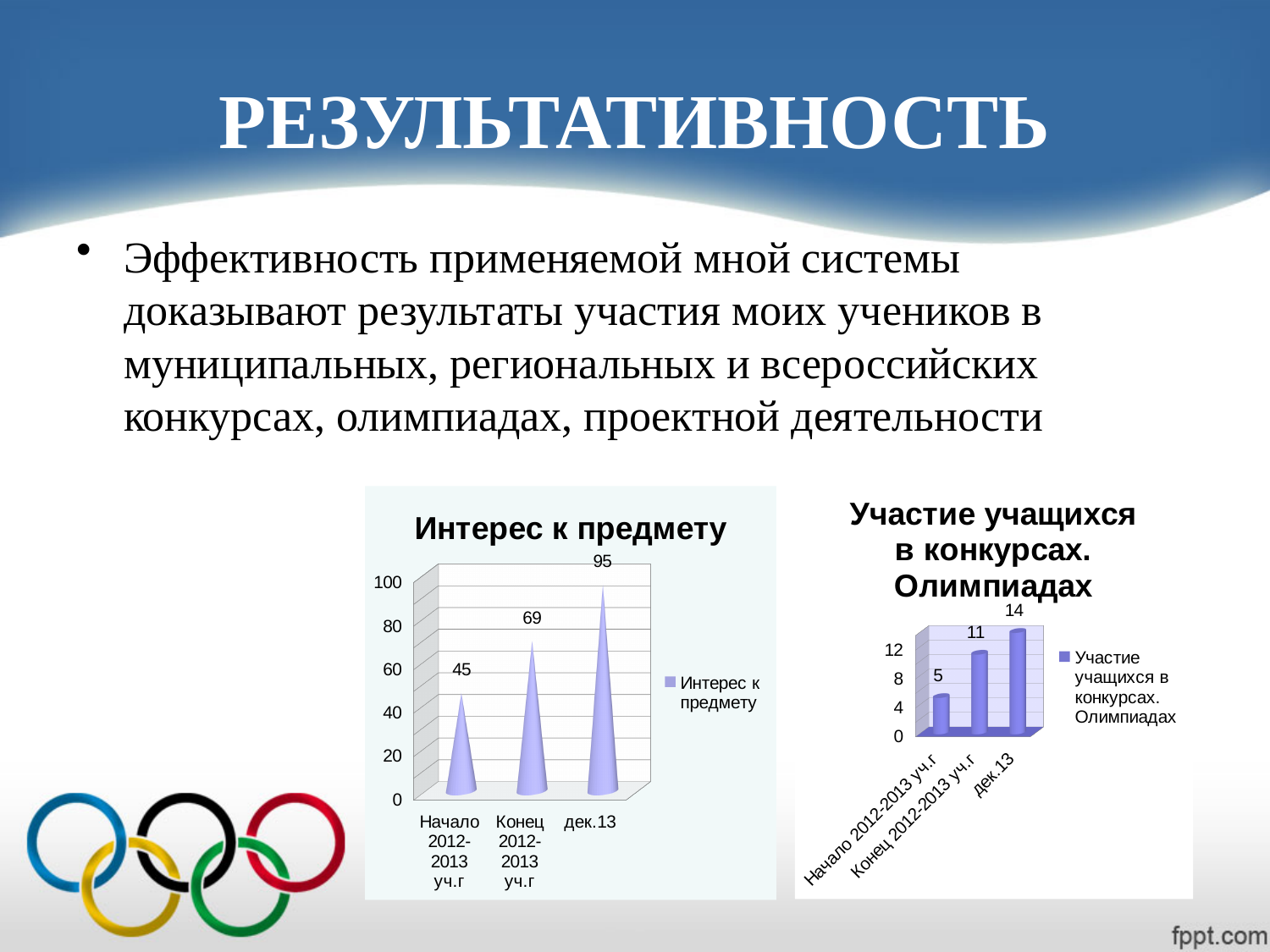
In the chart 'Интерес к предмету', which category has the lowest value? Начало 2012-2013 уч.г In the chart 'Интерес к предмету', what is the value for 'Конец 2012-2013 уч.г'? 69 In the chart 'Участие учащихся в конкурсах. Олимпиадах', what is the value for 'Начало 2012-2013 уч.г'? 5 In the chart 'Участие учащихся в конкурсах. Олимпиадах', which category has the highest value? дек.13 In the chart 'Интерес к предмету', do the values rise or fall from left to right along the x axis? rise In the chart 'Интерес к предмету', what is the value for 'дек.13'? 95 What kind of chart is 'Интерес к предмету'? bar chart In the chart 'Интерес к предмету', what is the difference between the values for 'дек.13' and 'Начало 2012-2013 уч.г'? 50 In the chart 'Участие учащихся в конкурсах. Олимпиадах', which is larger: the value for 'Конец 2012-2013 уч.г' or for 'дек.13'? дек.13 In the chart 'Участие учащихся в конкурсах. Олимпиадах', what is the difference between the values for 'Конец 2012-2013 уч.г' and 'Начало 2012-2013 уч.г'? 6 In the chart 'Интерес к предмету', how many categories are plotted? 3 In the chart 'Участие учащихся в конкурсах. Олимпиадах', what is the value for 'дек.13'? 14